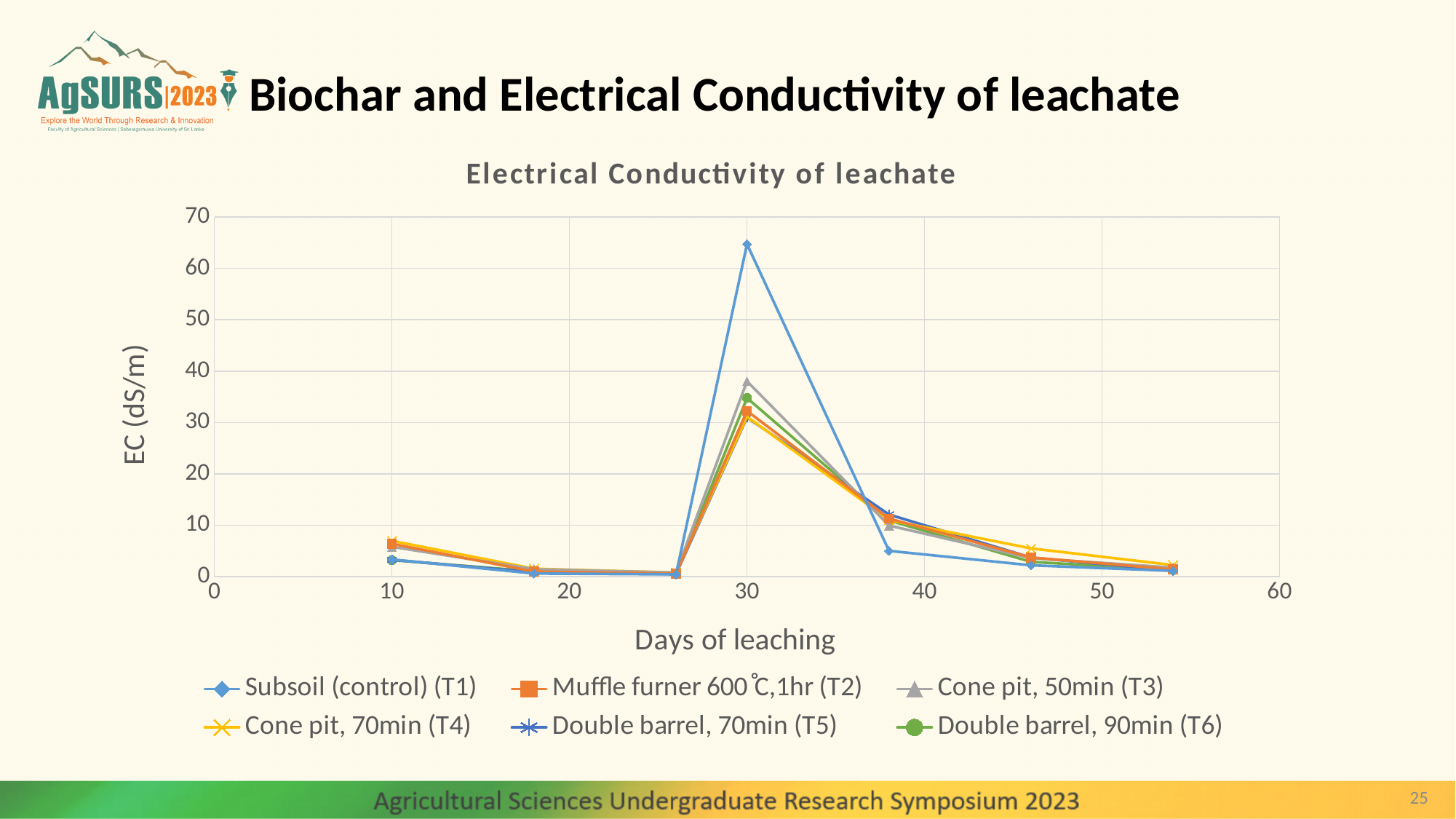
Is the value for Subsoil (control) (T1) at day 10 greater or less than 10? less Is the value for Subsoil (control) (T1) at day 38 greater or less than 10? less What is the label of the y axis? EC (dS/m) What kind of chart is shown on the slide? line chart What is the title of the chart? Electrical Conductivity of leachate Is the value for Double barrel, 90min (T6) at day 30 greater or less than 30? greater Do the EC values for Subsoil (control) (T1) rise or fall between day 30 and day 40? fall At day 30, which is larger: the value for Subsoil (control) (T1) or the value for Muffle furner 600°C,1hr (T2)? Subsoil (control) (T1) Which series has the highest EC value at day 30? Subsoil (control) (T1) How many series does the legend list? 6